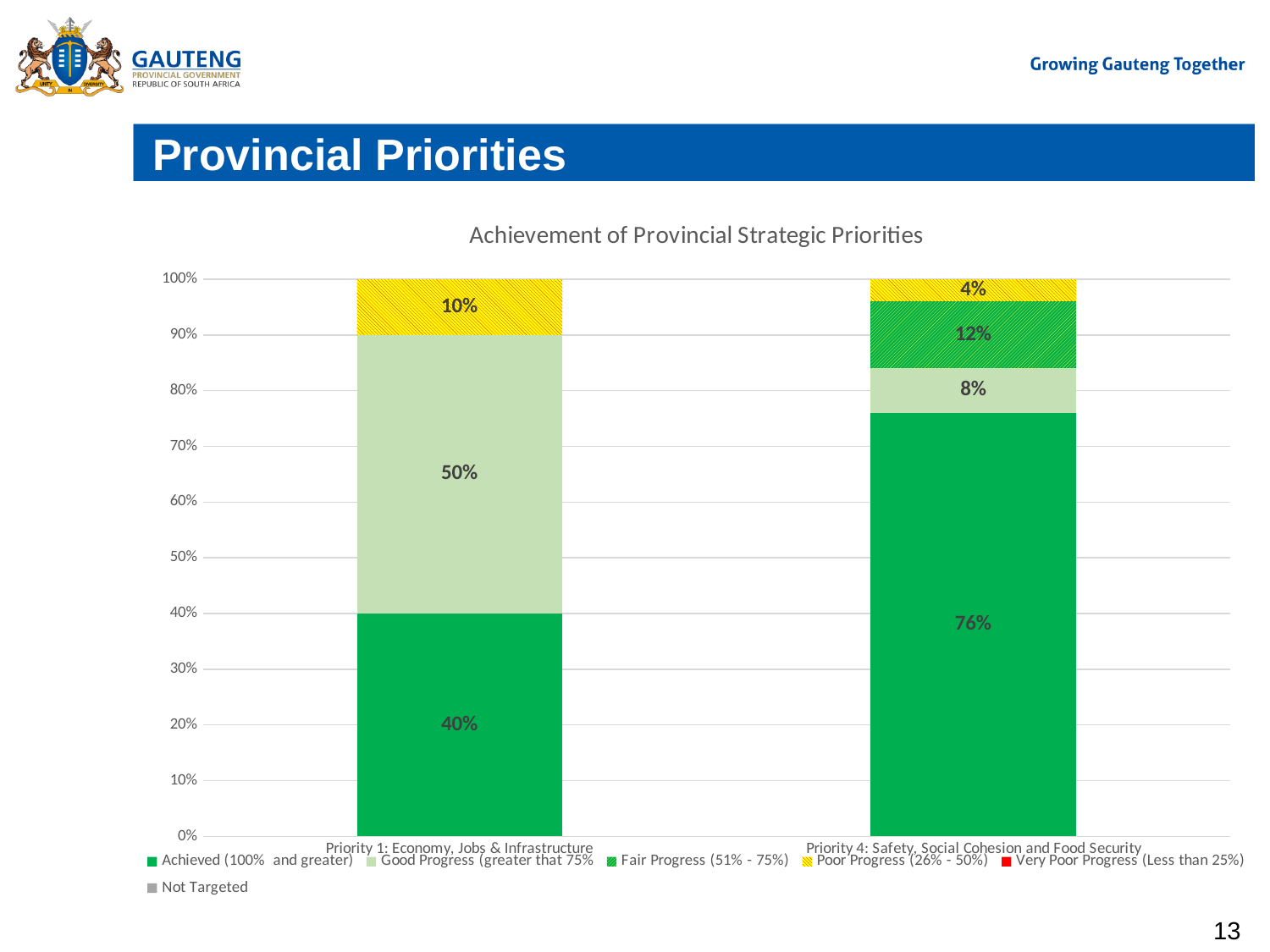
What is the Fair Progress (51% - 75%) value for Priority 4: Safety, Social Cohesion and Food Security? 12% Which category has the lower Poor Progress (26% - 50%) value? Priority 4: Safety, Social Cohesion and Food Security Which category has the higher Achieved (100% and greater) value? Priority 4: Safety, Social Cohesion and Food Security What is the difference between the Good Progress values for Priority 1 and Priority 4? 42% What is the difference between the Achieved values for Priority 4 and Priority 1? 36% What is the title of the chart? Achievement of Provincial Strategic Priorities What is the Poor Progress (26% - 50%) value for Priority 4: Safety, Social Cohesion and Food Security? 4% How many series does the legend list? 6 What is the Good Progress value for Priority 1: Economy, Jobs & Infrastructure? 50% What type of chart is shown on the slide? Stacked bar chart How many categories are plotted on the x axis? 2 What is the Achieved (100% and greater) value for Priority 1: Economy, Jobs & Infrastructure? 40%